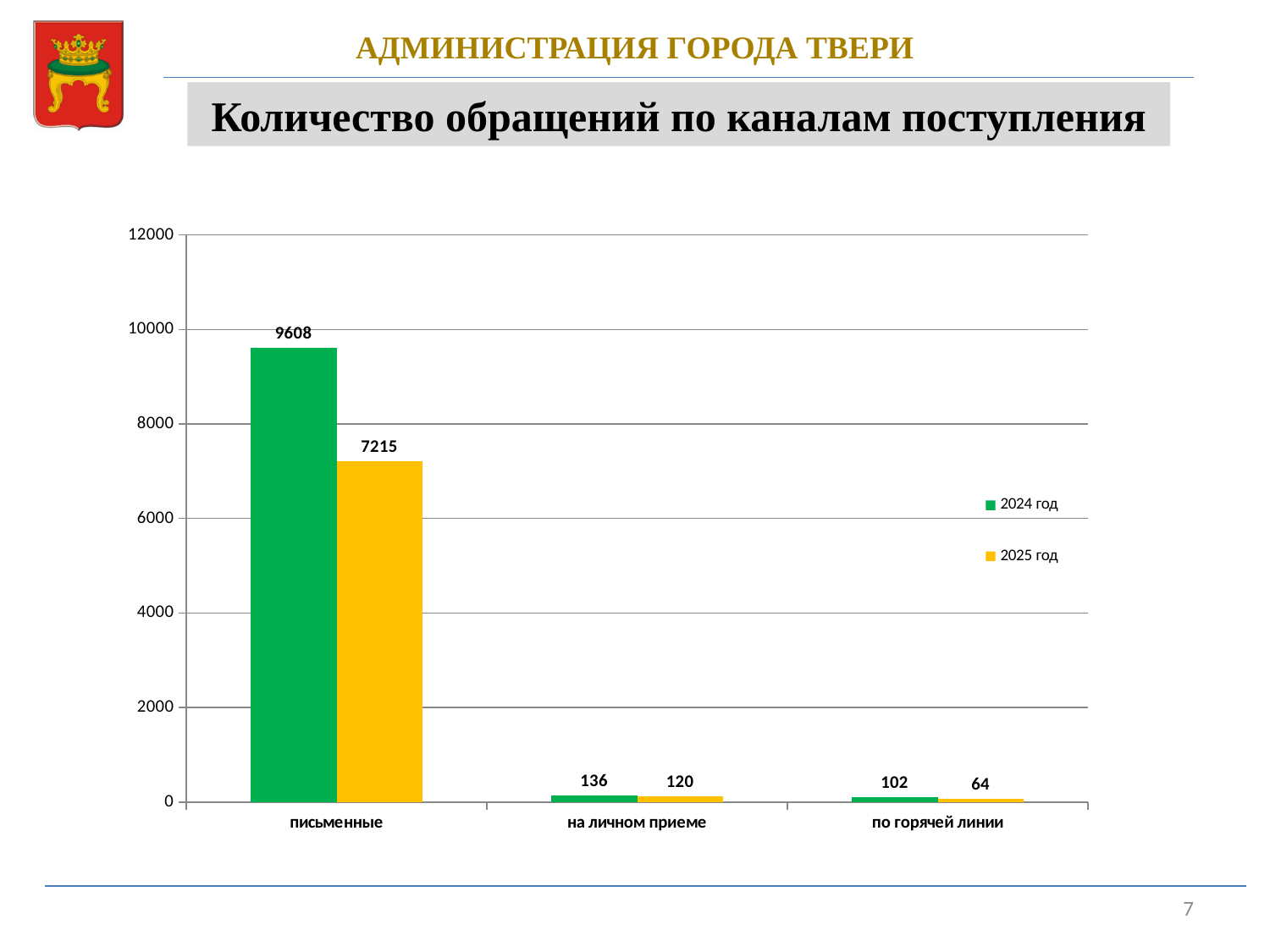
What is the value for письменные in 2024 год? 9608 How many series does the legend list? 2 Which category has the lowest value in 2025 год? по горячей линии What is the difference between the 2024 год and 2025 год values for по горячей линии? 38 Which is larger for на личном приеме: the 2024 год value or the 2025 год value? 2024 год What is the value for на личном приеме in 2025 год? 120 What is the value for письменные in 2025 год? 7215 What is the difference between the 2024 год and 2025 год values for письменные? 2393 How many categories are shown on the x axis? 3 Which category has the highest value in 2024 год? письменные What is the value for по горячей линии in 2024 год? 102 What kind of chart is shown on the slide? bar chart